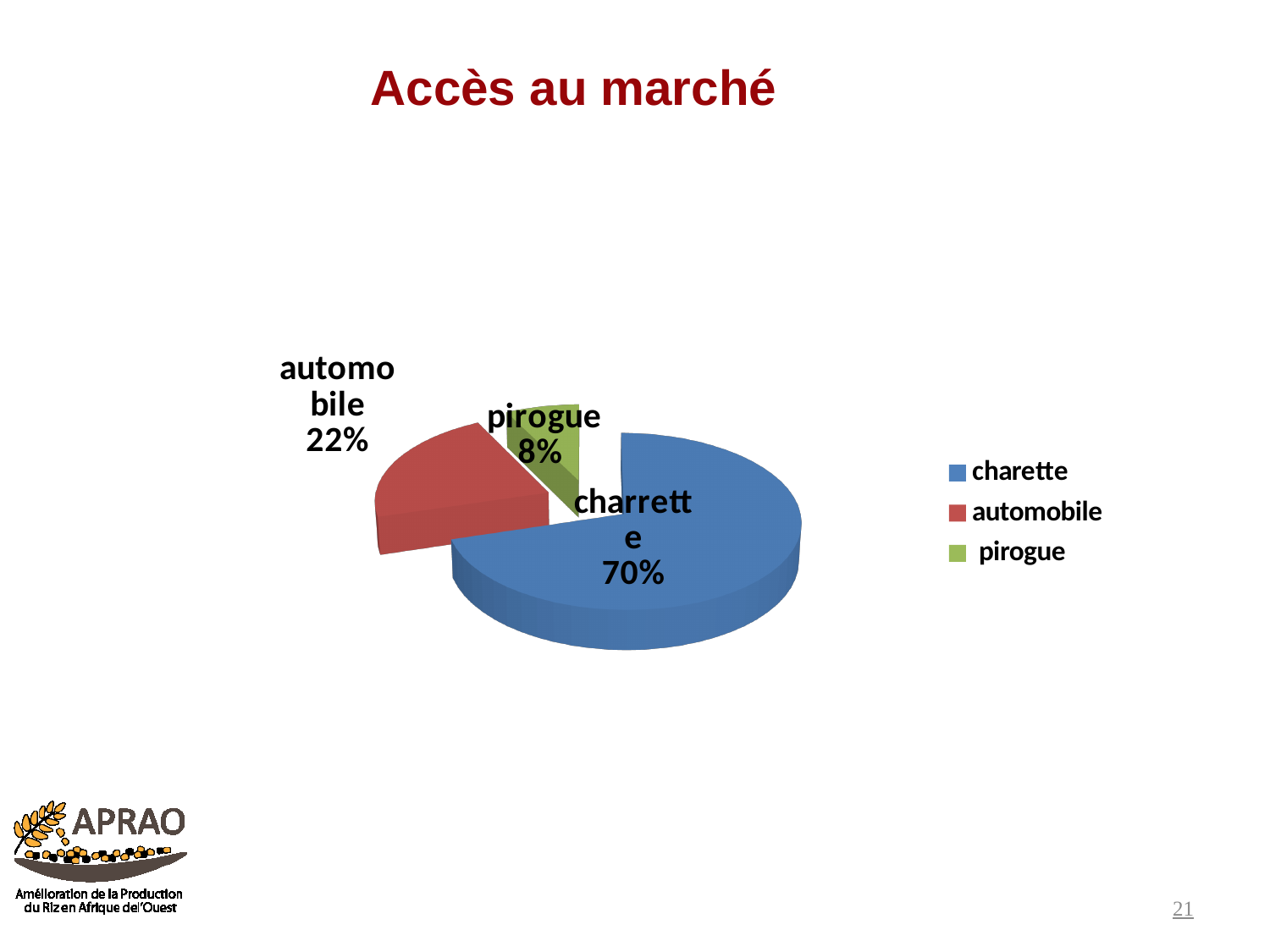
What is the difference in percentage points between the automobile and pirogue slices? 14 What kind of chart is shown on the slide? pie chart Which is larger, the automobile slice or the pirogue slice? automobile Which category has the smallest slice of the pie? pirogue How many categories are shown in the pie chart? 3 What share of the pie does automobile represent? 22% What share of the pie does charrette represent? 70% What share of the pie does pirogue represent? 8% What is the title of the slide? Accès au marché Which category has the largest slice of the pie? charrette What colour is the charrette slice in the pie chart? blue What is the difference in percentage points between the charrette and automobile slices? 48